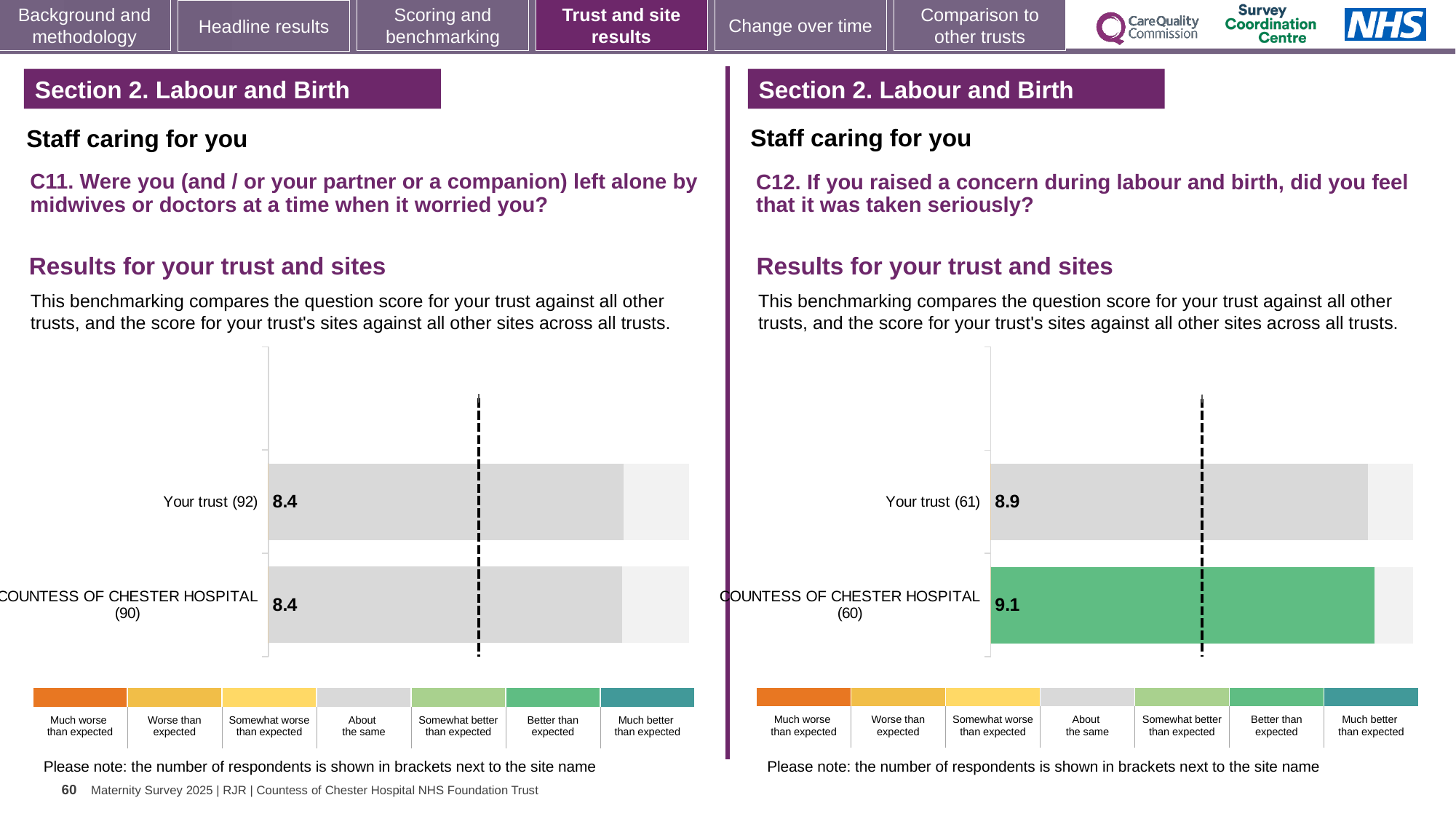
On the C11 chart (left), what is the score for Your trust? 8.4 On the C12 chart (right), which has the higher score, Your trust or Countess of Chester Hospital? Countess of Chester Hospital On the C12 chart (right), what is the score for Countess of Chester Hospital? 9.1 On the C11 chart (left), what is the score for Countess of Chester Hospital? 8.4 On the C12 chart (right), what is the difference between the Countess of Chester Hospital score and the Your trust score? 0.2 On the C12 chart (right), which bar is coloured green? Countess of Chester Hospital What type of chart is used on the C12 chart (right)? Bar chart On the C11 chart (left), how many bars are plotted? 2 On the C12 chart (right), what is the score for Your trust? 8.9 On the C12 chart (right), how many respondents are shown in brackets for Countess of Chester Hospital? 60 On the C11 chart (left), how many respondents are shown in brackets for Your trust? 92